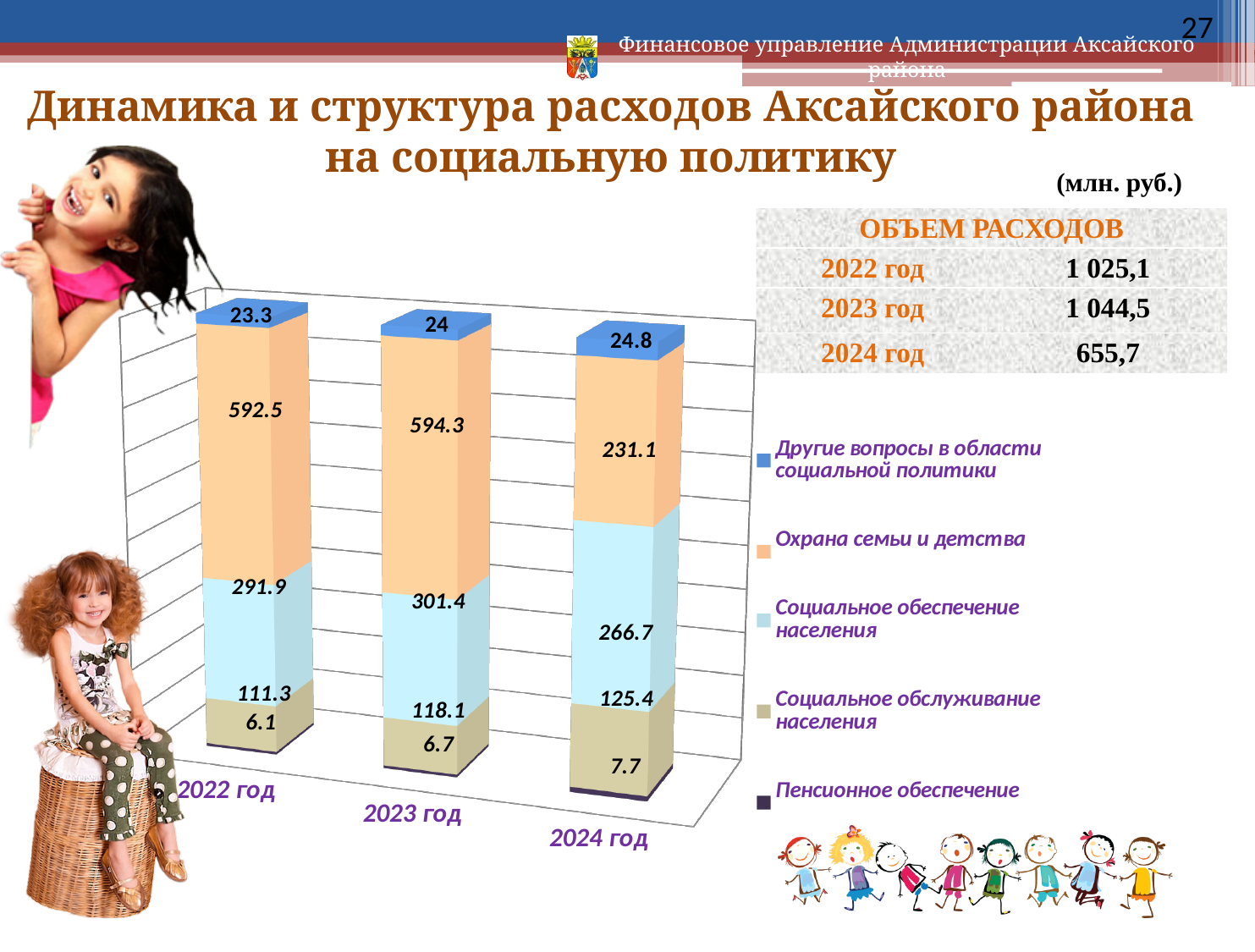
In which year is the value for Охрана семьи и детства the lowest? 2024 год Which is larger: Социальное обеспечение населения in 2022 год or in 2023 год? 2023 год What is the value for Социальное обеспечение населения in 2024 год? 266.7 How many years (categories) are shown on the x axis of the chart? 3 What is the value for Пенсионное обеспечение in 2023 год? 6.7 What kind of chart is shown on the slide? stacked bar chart What is the value for Другие вопросы в области социальной политики in 2024 год? 24.8 In which year is the value for Социальное обслуживание населения the highest? 2024 год How many series does the chart legend list? 5 What is the total of the stacked bar for 2024 год? 655.7 What is the value for Охрана семьи и детства in 2022 год? 592.5 What is the difference between the Охрана семьи и детства values for 2023 год and 2024 год? 363.2